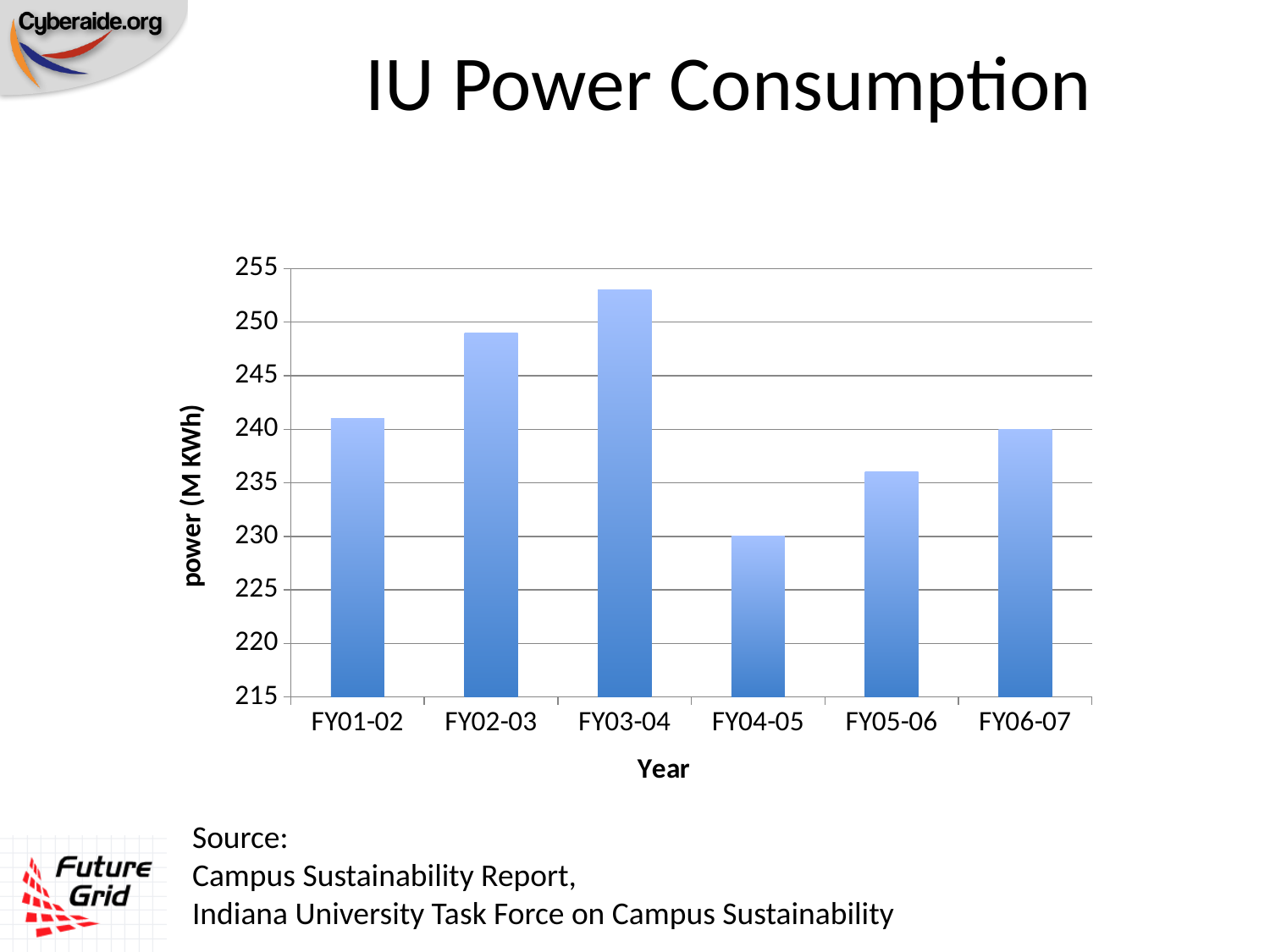
Is the value for FY02-03 greater or less than 245? greater What is the label of the vertical axis of the chart? power (M KWh) What kind of chart is shown on the slide? bar chart What is the power consumption for FY06-07? 240 How many fiscal years are shown on the x axis of the chart? 6 What is the power consumption for FY04-05? 230 Does power consumption rise or fall from FY03-04 to FY04-05? fall Which has higher power consumption, FY01-02 or FY05-06? FY01-02 Is the value for FY03-04 greater or less than 250? greater Is the value for FY05-06 greater or less than 240? less Which fiscal year has the lowest power consumption? FY04-05 Which fiscal year has the highest power consumption? FY03-04